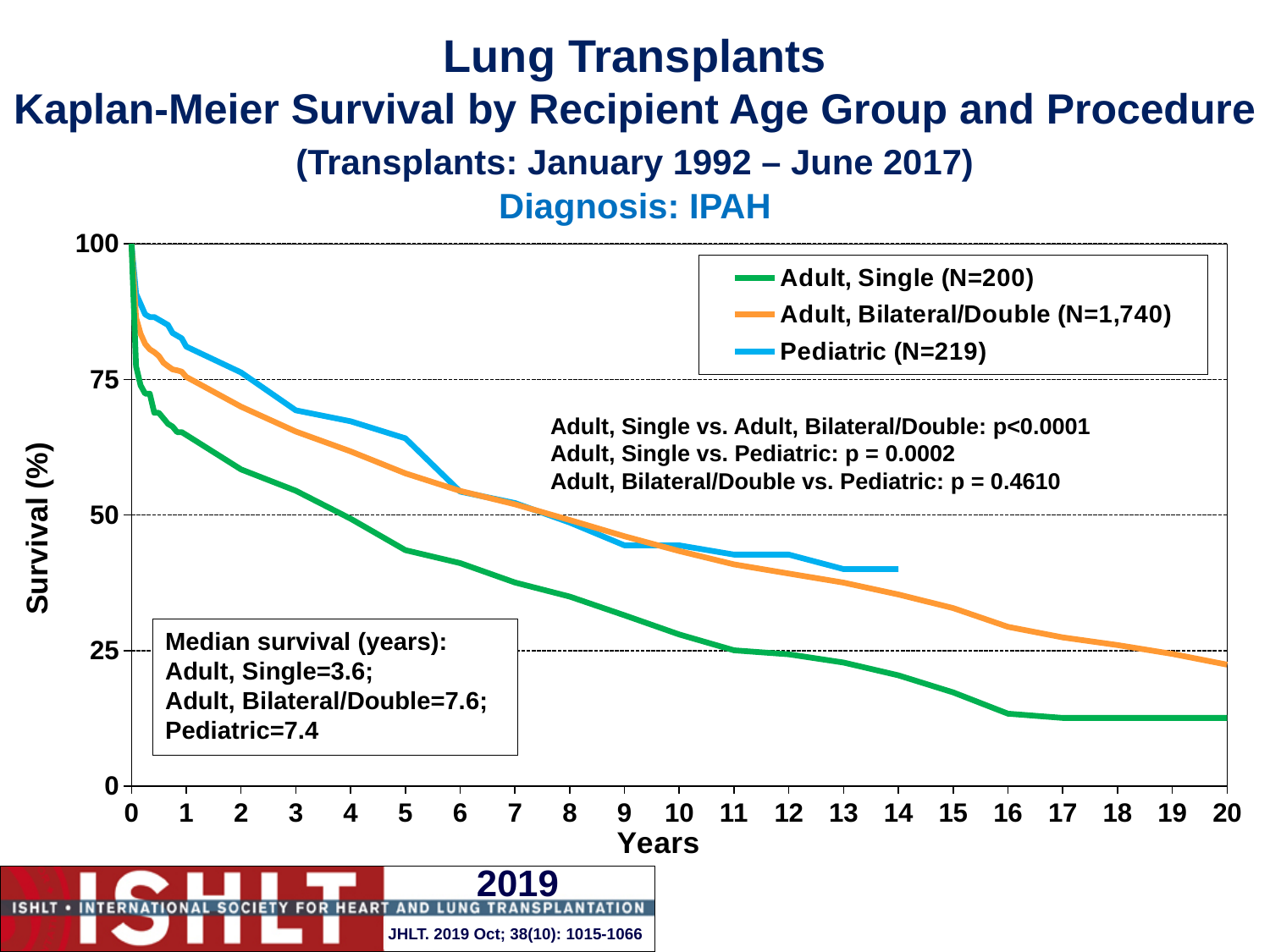
Which group has the higher median survival, Adult, Bilateral/Double or Pediatric? Adult, Bilateral/Double What kind of chart is shown on the slide? Line chart Do the survival curves rise or fall as years increase along the x axis? fall What is the median survival in years for the Adult, Bilateral/Double group? 7.6 Which group has the lowest median survival? Adult, Single How many series does the legend list? 3 Is the survival value for the Pediatric group at 5 years greater or less than 50? greater What is the N for the Adult, Bilateral/Double group shown in the legend? 1,740 What is the median survival in years for the Adult, Single group? 3.6 What is the difference in median survival (years) between the Adult, Bilateral/Double group and the Adult, Single group? 4.0 Is the survival value for the Adult, Single group at 10 years greater or less than 50? less What is the median survival in years for the Pediatric group? 7.4